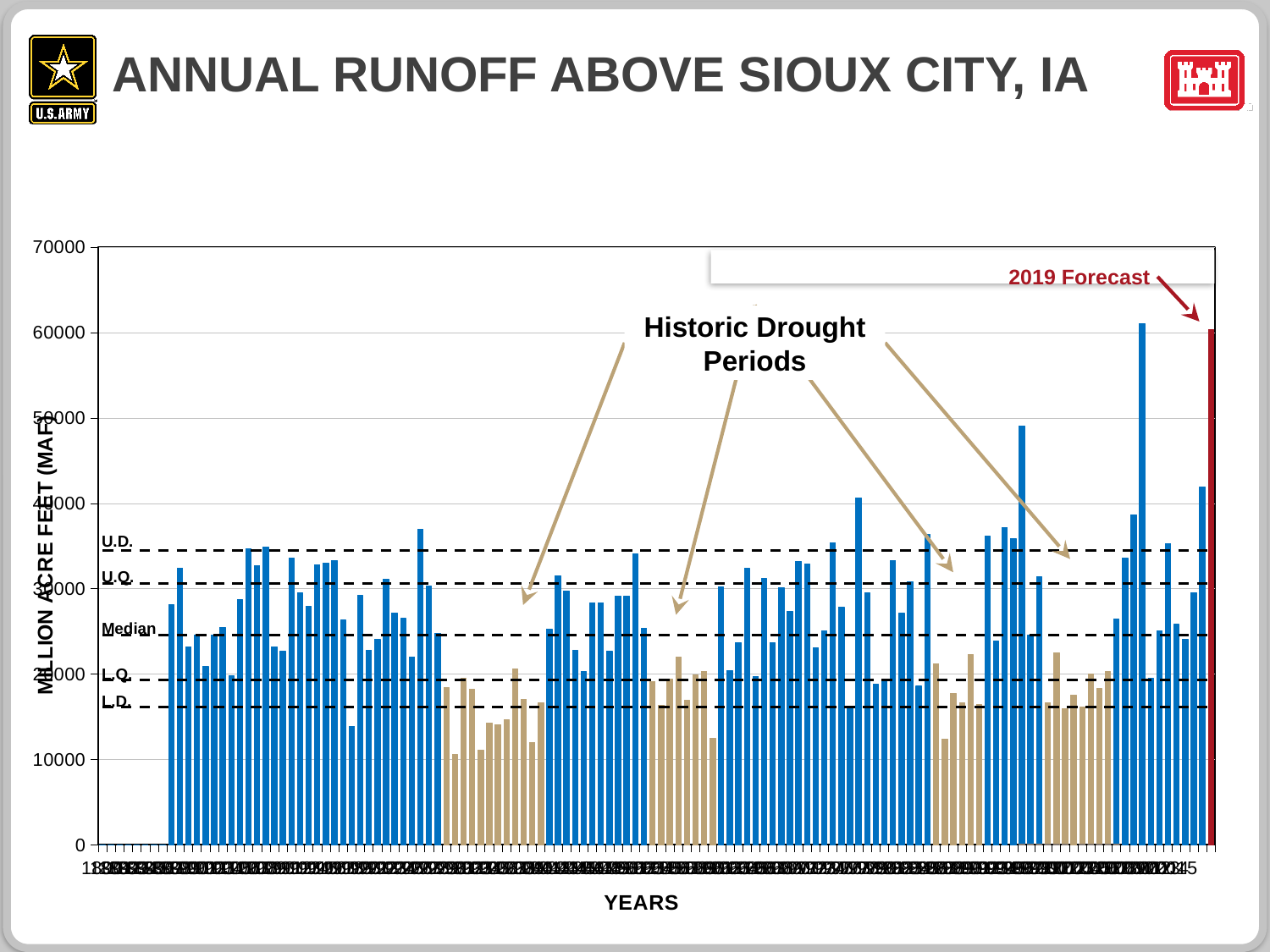
What is the title of the chart? ANNUAL RUNOFF ABOVE SIOUX CITY, IA Is the Median reference line greater or less than 20000? greater Is the value for the 2019 Forecast bar greater or less than 70000? less What kind of chart is shown on the slide? Bar chart Is the value for the 2019 Forecast bar greater or less than 50000? greater What is the label on the vertical axis of the chart? MILLION ACRE FEET (MAF)